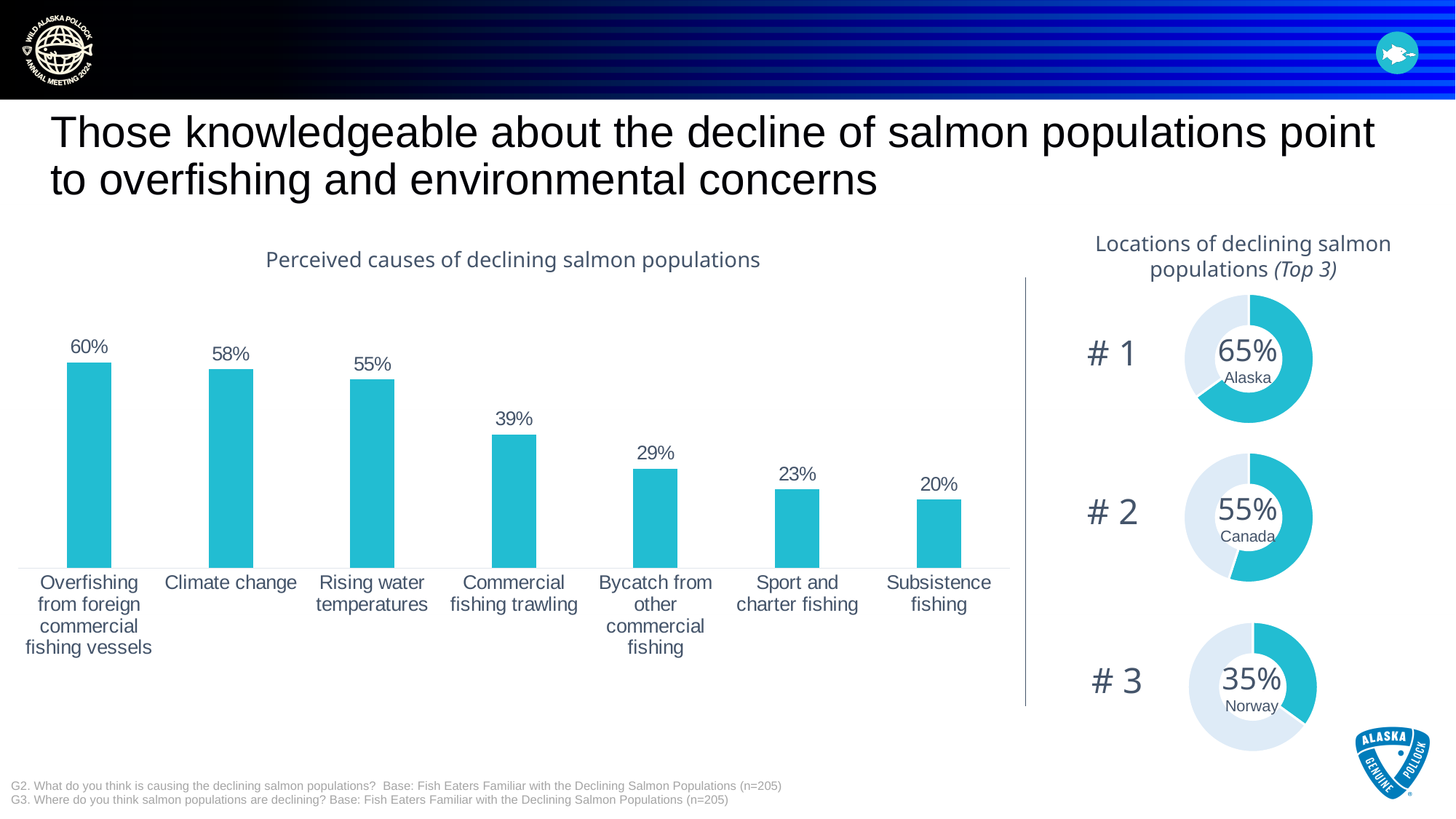
In the 'Perceived causes of declining salmon populations' chart, which category has the highest value? Overfishing from foreign commercial fishing vessels In the 'Perceived causes of declining salmon populations' chart, which category has the lowest value? Subsistence fishing In the 'Locations of declining salmon populations (Top 3)' chart, what is the difference between Alaska and Norway? 30% How many categories are shown in the 'Perceived causes of declining salmon populations' chart? 7 What kind of chart is the 'Perceived causes of declining salmon populations' chart? Bar chart In the 'Perceived causes of declining salmon populations' chart, what is the difference between Rising water temperatures and Bycatch from other commercial fishing? 26% In the 'Locations of declining salmon populations (Top 3)' chart, what is the value for Canada? 55% In the 'Perceived causes of declining salmon populations' chart, which is larger: Sport and charter fishing or Subsistence fishing? Sport and charter fishing In the 'Perceived causes of declining salmon populations' chart, what is the value for Commercial fishing trawling? 39% In the 'Locations of declining salmon populations (Top 3)' chart, which location is ranked #1? Alaska In the 'Perceived causes of declining salmon populations' chart, do the values rise or fall from left to right? Fall In the 'Perceived causes of declining salmon populations' chart, what is the value for Climate change? 58%